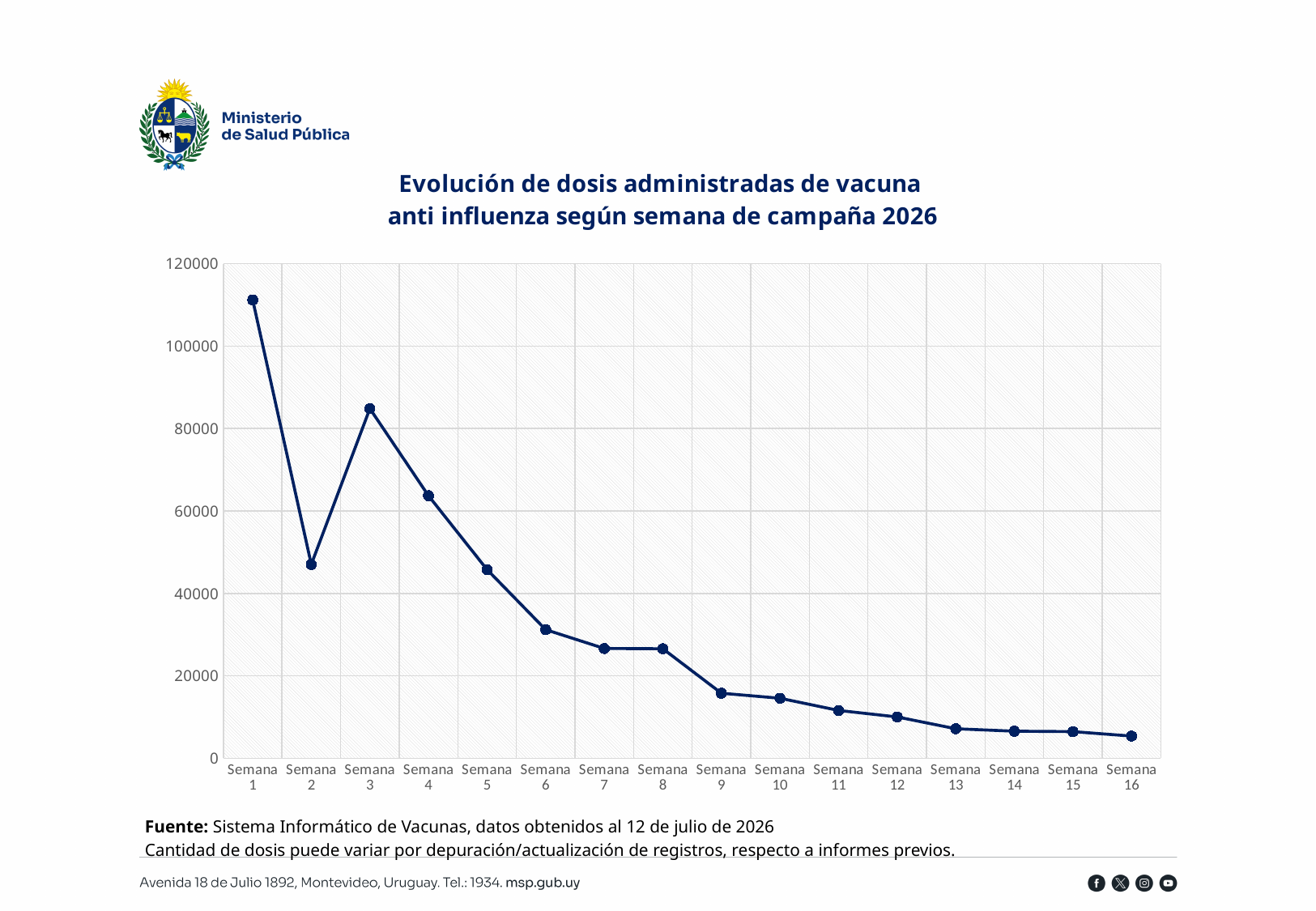
Is the value for Semana 2 greater or less than 60000? less Overall, do the values rise or fall from Semana 1 to Semana 16? fall Which is larger, the value for Semana 4 or the value for Semana 5? Semana 4 Is the value for Semana 6 greater or less than 40000? less Which is larger, the value for Semana 2 or the value for Semana 3? Semana 3 Is the value for Semana 3 greater or less than 80000? greater What kind of chart is shown on the slide? line chart Which week has the highest number of doses administered? Semana 1 What is the title of the chart? Evolución de dosis administradas de vacuna anti influenza según semana de campaña 2026 How many weeks (semanas) are plotted on the x axis? 16